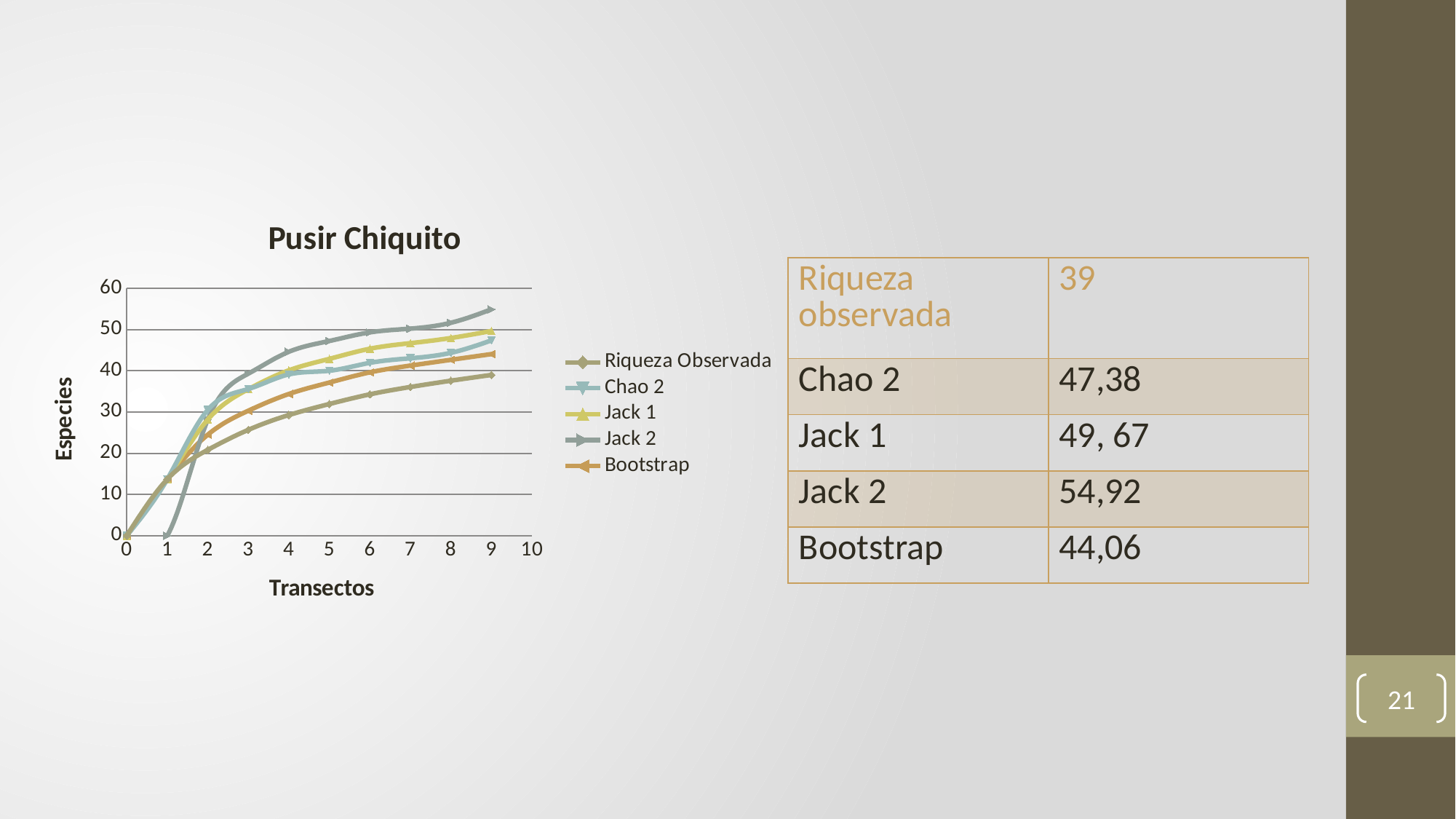
What type of chart is shown on the slide? line chart At transect 9, which series is higher: Jack 1 or Bootstrap? Jack 1 How many series does the legend of the Pusir Chiquito chart list? 5 Is the value for Riqueza Observada at transect 9 greater or less than 40? less Does the Riqueza Observada series rise or fall as the number of transects increases? rises Which series has the lowest value at transect 9? Riqueza Observada Which series has the highest value at transect 9? Jack 2 What is the title of the chart? Pusir Chiquito Is the value for Jack 2 at transect 9 greater or less than 50? greater Is the value for Jack 2 at transect 4 greater or less than 40? greater What is the value of Riqueza Observada at transect 0? 0 What is the label of the x axis of the chart? Transectos